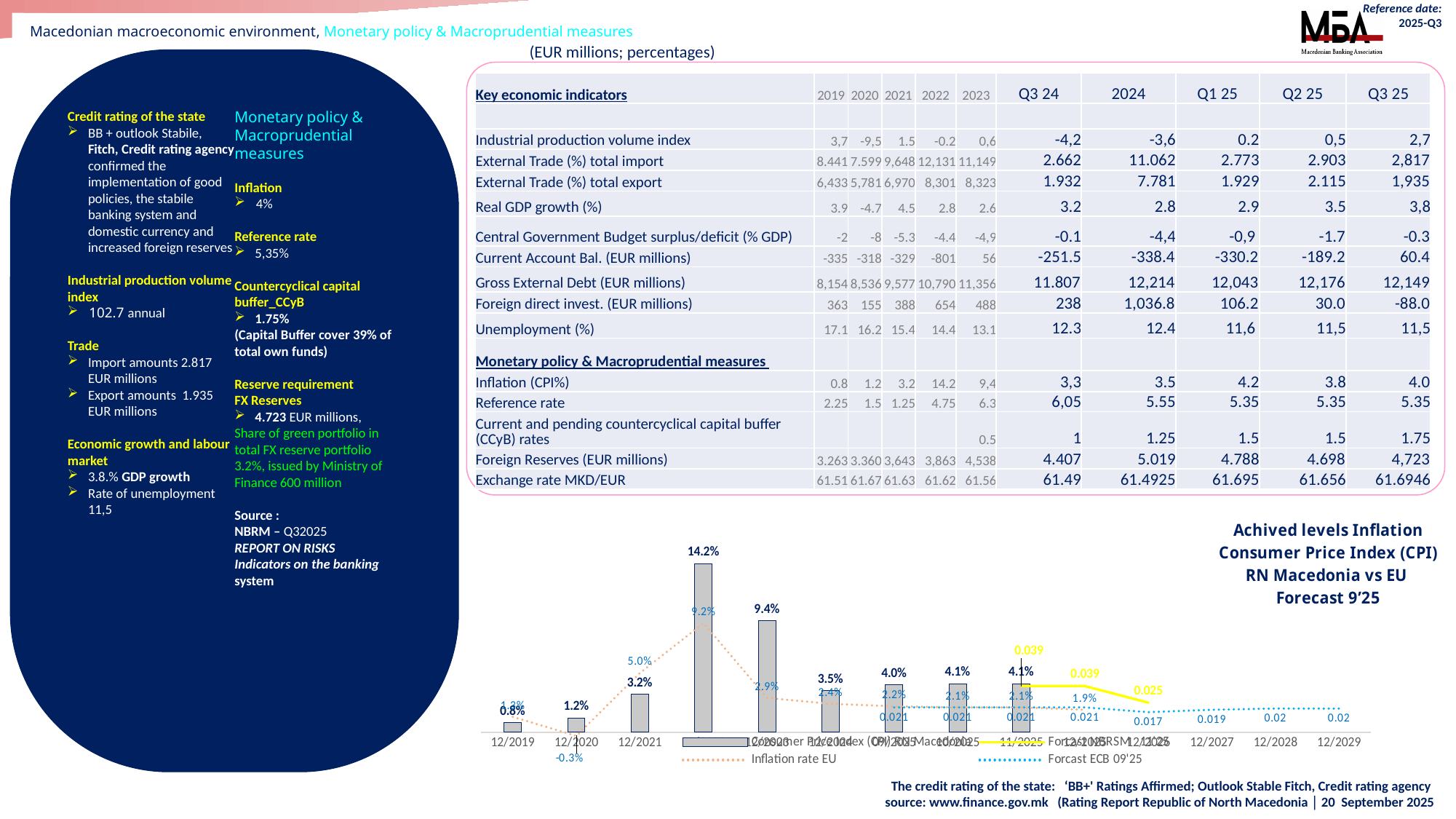
In the CPI chart at the bottom of the slide, what is the difference between the CPI RN Macedonia values for 12/2022 and 12/2023? 4.8 percentage points In the CPI chart at the bottom of the slide, what is the Inflation rate EU value labelled at 12/2022? 9.2% In the CPI chart at the bottom of the slide, which date has the lowest bar for the Consumer Price Index (CPI) RN Macedonia? 12/2019 In the CPI chart at the bottom of the slide, which date has the highest bar for the Consumer Price Index (CPI) RN Macedonia? 12/2022 In the CPI chart at the bottom of the slide, how many bars are plotted for the Consumer Price Index (CPI) RN Macedonia? 9 In the CPI chart at the bottom of the slide, do the CPI RN Macedonia bars rise or fall from 12/2022 to 12/2024? Fall In the CPI chart at the bottom of the slide, what is the CPI RN Macedonia value for 12/2024? 3.5% In the CPI chart at the bottom of the slide, which is larger: the CPI RN Macedonia bar for 12/2021 or for 12/2024? 12/2024 What kind of chart is the CPI chart at the bottom of the slide? Bar chart combined with line series In the CPI chart at the bottom of the slide, what is the CPI RN Macedonia value for 12/2022? 14.2% In the CPI chart at the bottom of the slide, what is the CPI RN Macedonia value for 12/2023? 9.4%